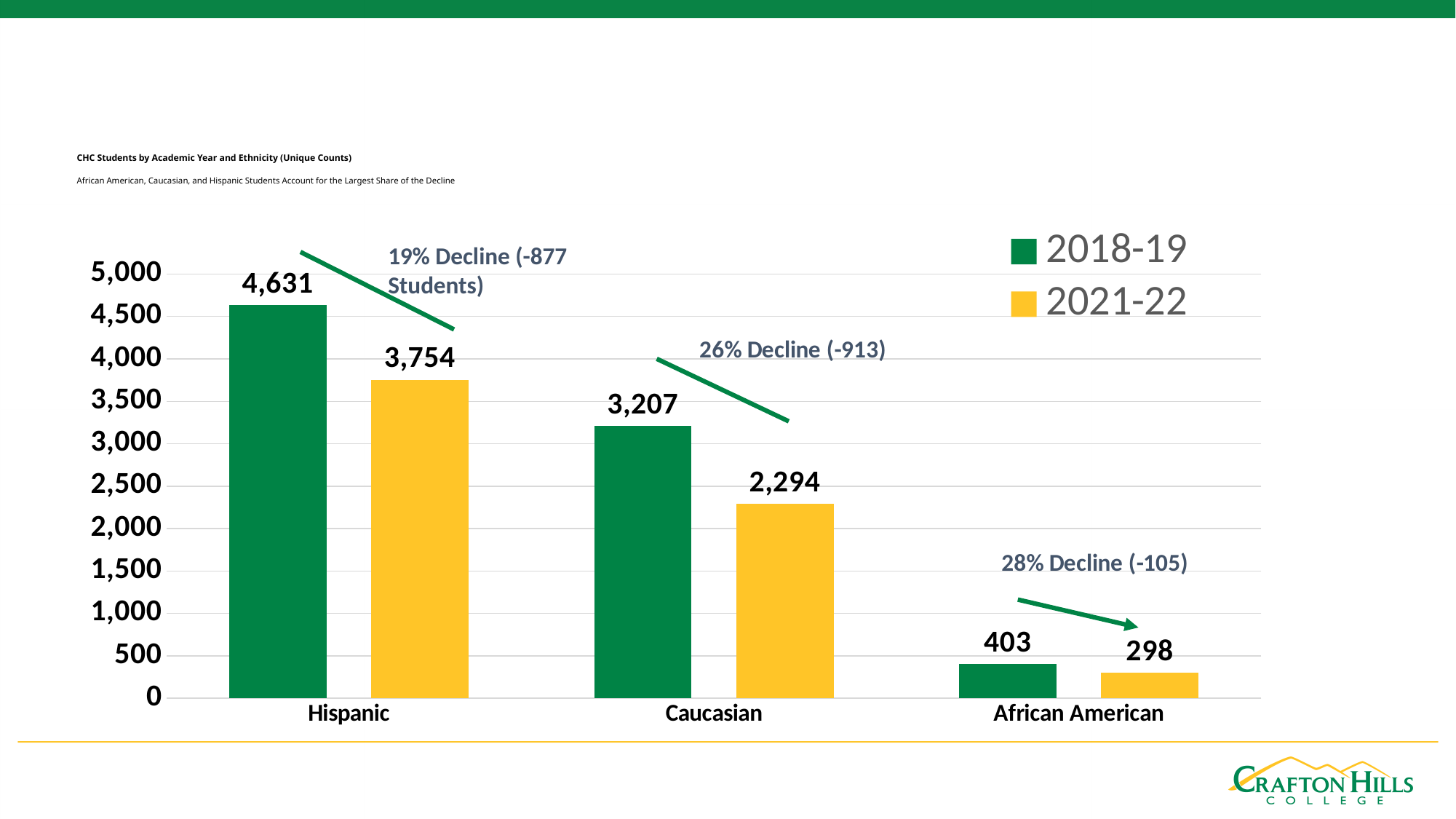
What is the value for African American students in 2018-19? 403 Which ethnicity has the highest value in 2021-22? Hispanic Which colour represents the 2021-22 series? Yellow What kind of chart is shown on the slide? Bar chart How many series does the legend list? 2 Which is larger: the 2021-22 value for Hispanic students or the 2018-19 value for Caucasian students? 2021-22 value for Hispanic students How many ethnicity categories are shown on the x axis? 3 What is the value for Hispanic students in 2018-19? 4,631 What is the value for Caucasian students in 2021-22? 2,294 What is the difference between the 2018-19 and 2021-22 values for Caucasian students? 913 What is the difference between the 2018-19 and 2021-22 values for African American students? 105 Which ethnicity has the lowest value in 2018-19? African American